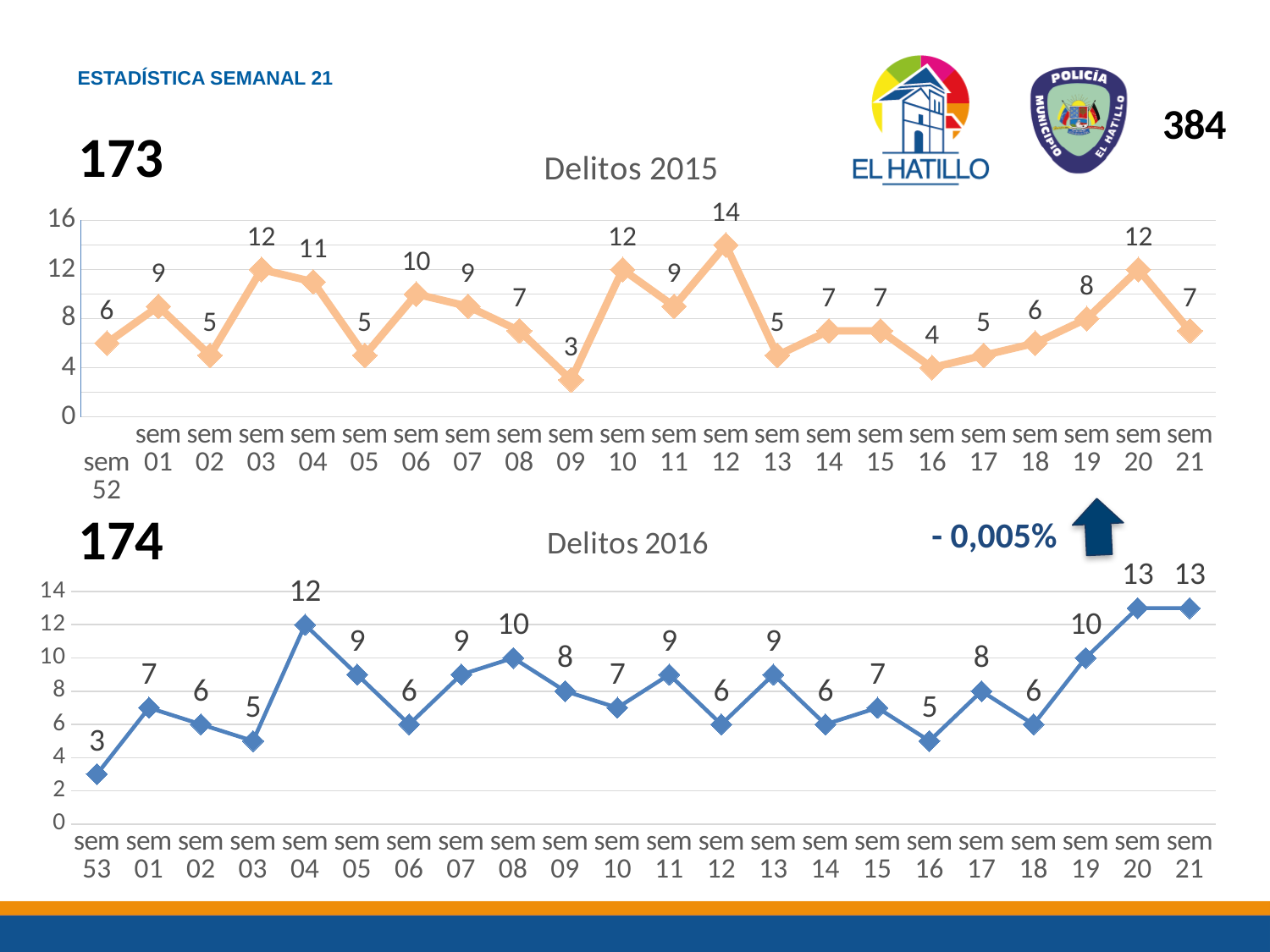
In the Delitos 2016 chart, which week has the lowest value? sem 53 In the Delitos 2016 chart, which is larger, the value for sem 08 or the value for sem 10? sem 08 What is the title of the lower chart on the slide? Delitos 2016 In the Delitos 2015 chart, what is the value for sem 12? 14 What kind of chart is the Delitos 2015 chart? Line chart In the Delitos 2016 chart, what is the value for sem 04? 12 In the Delitos 2016 chart, do the values rise or fall from sem 18 to sem 20? Rise In the Delitos 2015 chart, what is the difference between the values for sem 20 and sem 21? 5 How many data points are plotted in the Delitos 2016 chart? 22 In the Delitos 2015 chart, which week has the lowest value? sem 09 In the Delitos 2016 chart, what is the difference between the values for sem 20 and sem 16? 8 In the Delitos 2015 chart, which week has the highest value? sem 12